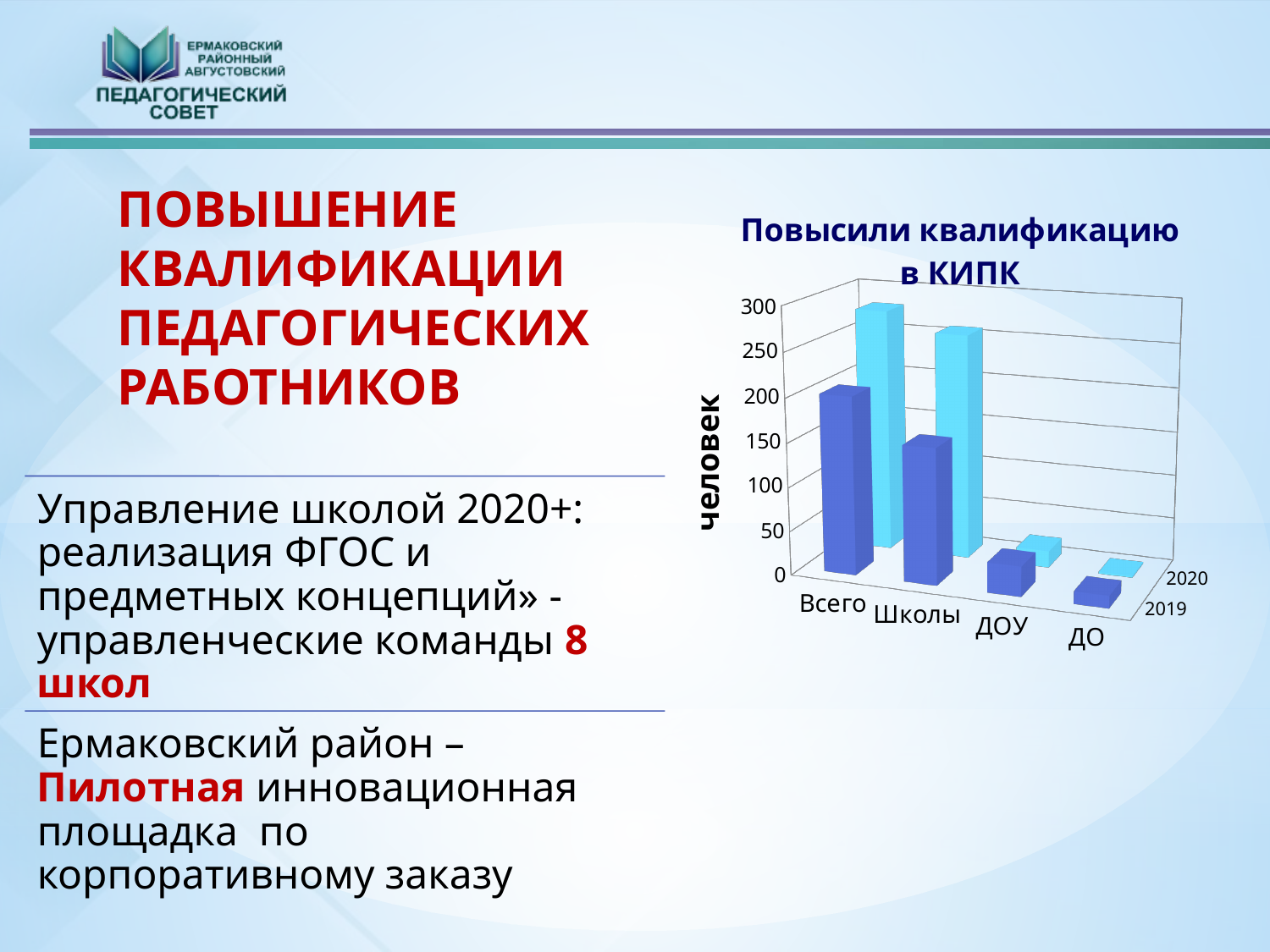
How many series (years) does the chart show? 2 Is the 2019 value for Школы greater or less than 200? less Which category has the highest value for 2019? Всего Is the 2019 value for Всего greater or less than 150? greater What kind of chart is shown on the slide? Bar chart Which category has the lowest value for 2019? ДО What is the label of the vertical axis of the chart? человек Is the 2019 value for ДОУ greater or less than 50? less How many categories are shown on the x axis of the chart? 4 Do the 2019 values rise or fall moving from Всего to ДО along the x axis? fall What is the title of the chart? Повысили квалификацию в КИПК For Всего, which year has the larger value, 2019 or 2020? 2020